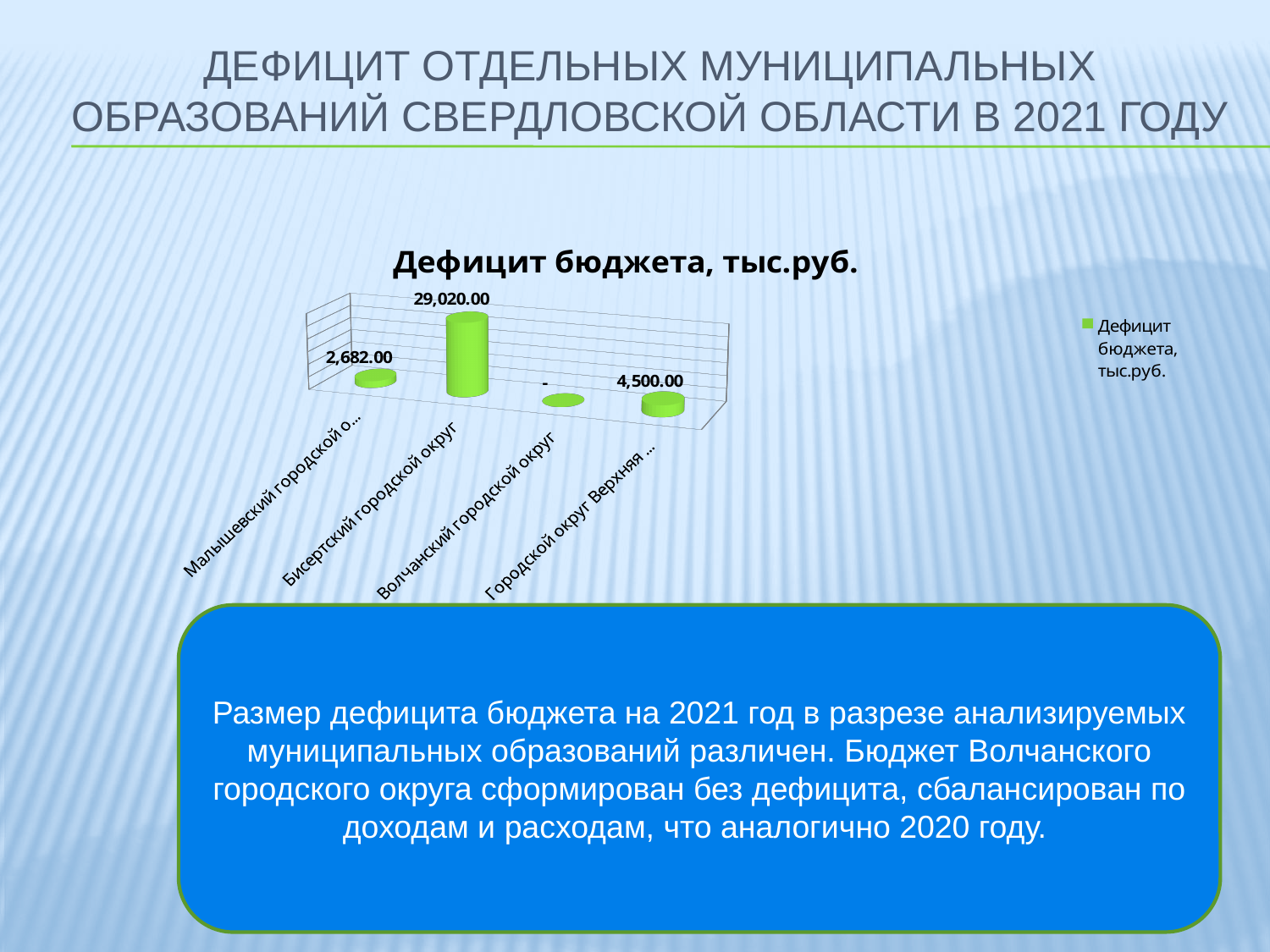
Which category has the highest budget deficit in the chart? Бисертский городской округ How many series does the legend list? 1 What is the difference between the values for Бисертский городской округ and the category labelled "Городской округ Верхняя ..."? 24,520.00 What is the title of the chart? Дефицит бюджета, тыс.руб. What is the value for Бисертский городской округ in the chart? 29,020.00 What is the value for the category labelled "Малышевский городской о..."? 2,682.00 What kind of chart is shown on the slide? Bar chart What is the value shown for Волчанский городской округ in the chart? - Which is larger: the value for "Городской округ Верхняя ..." or the value for "Малышевский городской о..."? Городской округ Верхняя ... What colour are the bars in the chart? Green How many categories are plotted in the chart? 4 What is the value for the category labelled "Городской округ Верхняя ..."? 4,500.00